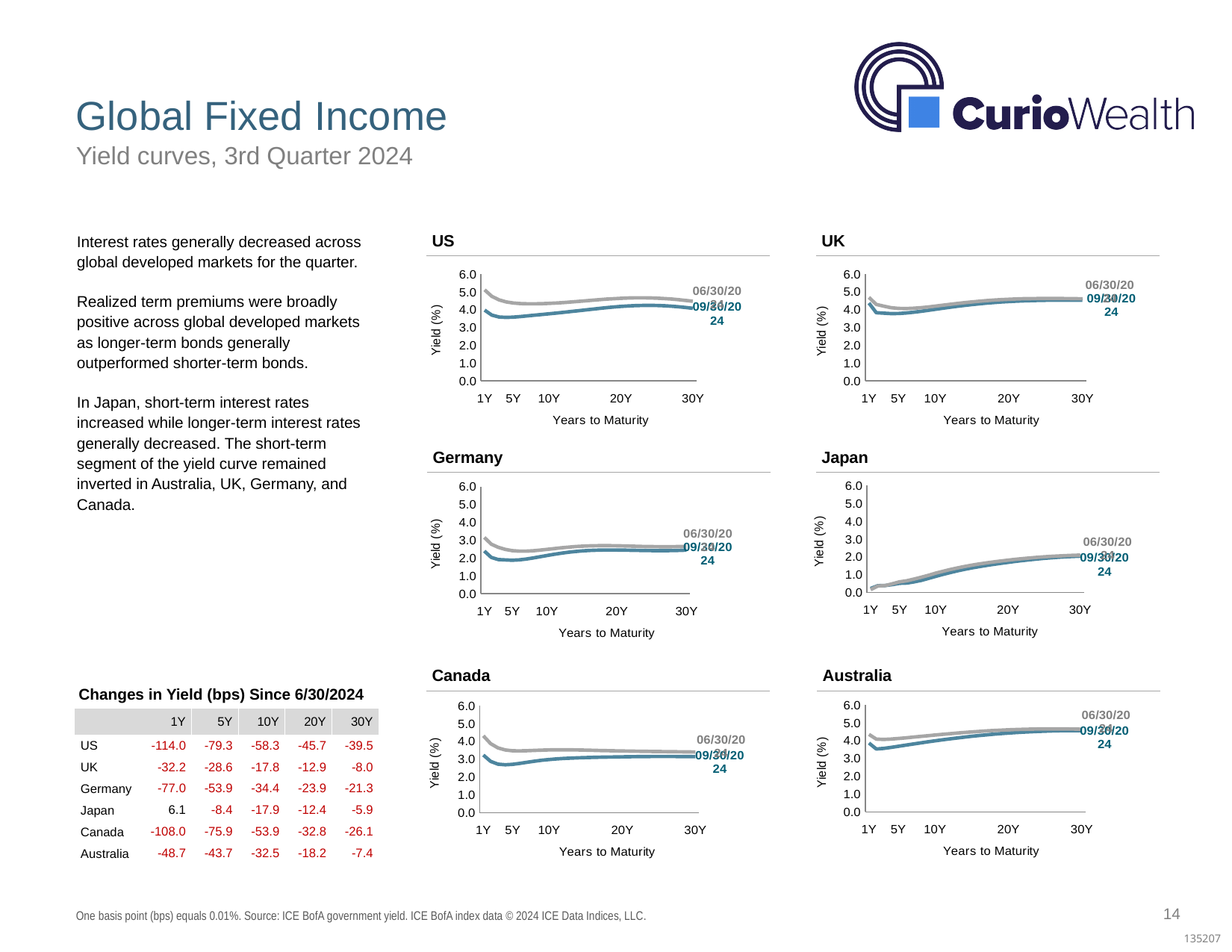
In the US chart, is the 09/30/2024 yield at 5Y greater or less than 4.0? less In the Japan chart, is the 09/30/2024 yield at 1Y greater or less than 1.0? less In the Canada chart, is the 09/30/2024 yield at 5Y greater or less than 3.0? less In the US chart, which series is higher at 1Y, 06/30/2024 or 09/30/2024? 06/30/2024 What kind of chart is the US chart? line chart In the Japan chart, does the 09/30/2024 yield rise or fall as years to maturity increase from 1Y to 30Y? rise What is the x-axis label on the Germany chart? Years to Maturity How many series does the Japan chart show? 2 How many yield curve charts are on the slide? 6